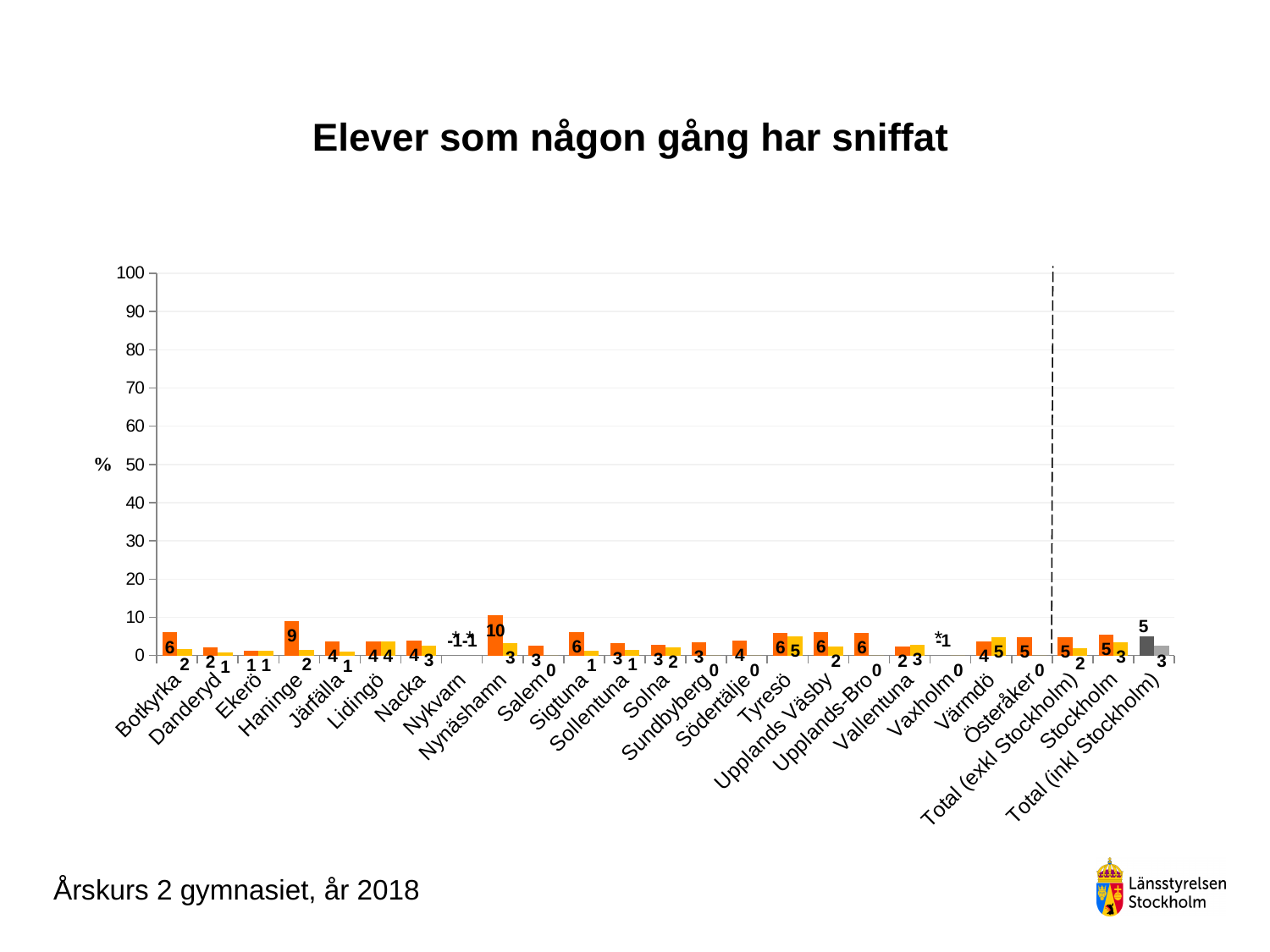
Which category has the highest orange bar? Nynäshamn What is the value of the yellow bar for Tyresö? 5 Which is larger, the orange bar for Sigtuna or the orange bar for Danderyd? Sigtuna What is the title of the chart? Elever som någon gång har sniffat What is the value of the orange bar for Haninge? 9 What kind of chart is shown on the slide? bar chart What is the value of the yellow bar for Salem? 0 What is the value of the orange bar for Stockholm? 5 Is the value of the orange bar for Nynäshamn greater or less than 20? less How many categories are shown on the x axis? 25 What is the value of the orange bar for Botkyrka? 6 What is the difference between the orange bar for Nynäshamn and the orange bar for Haninge? 1